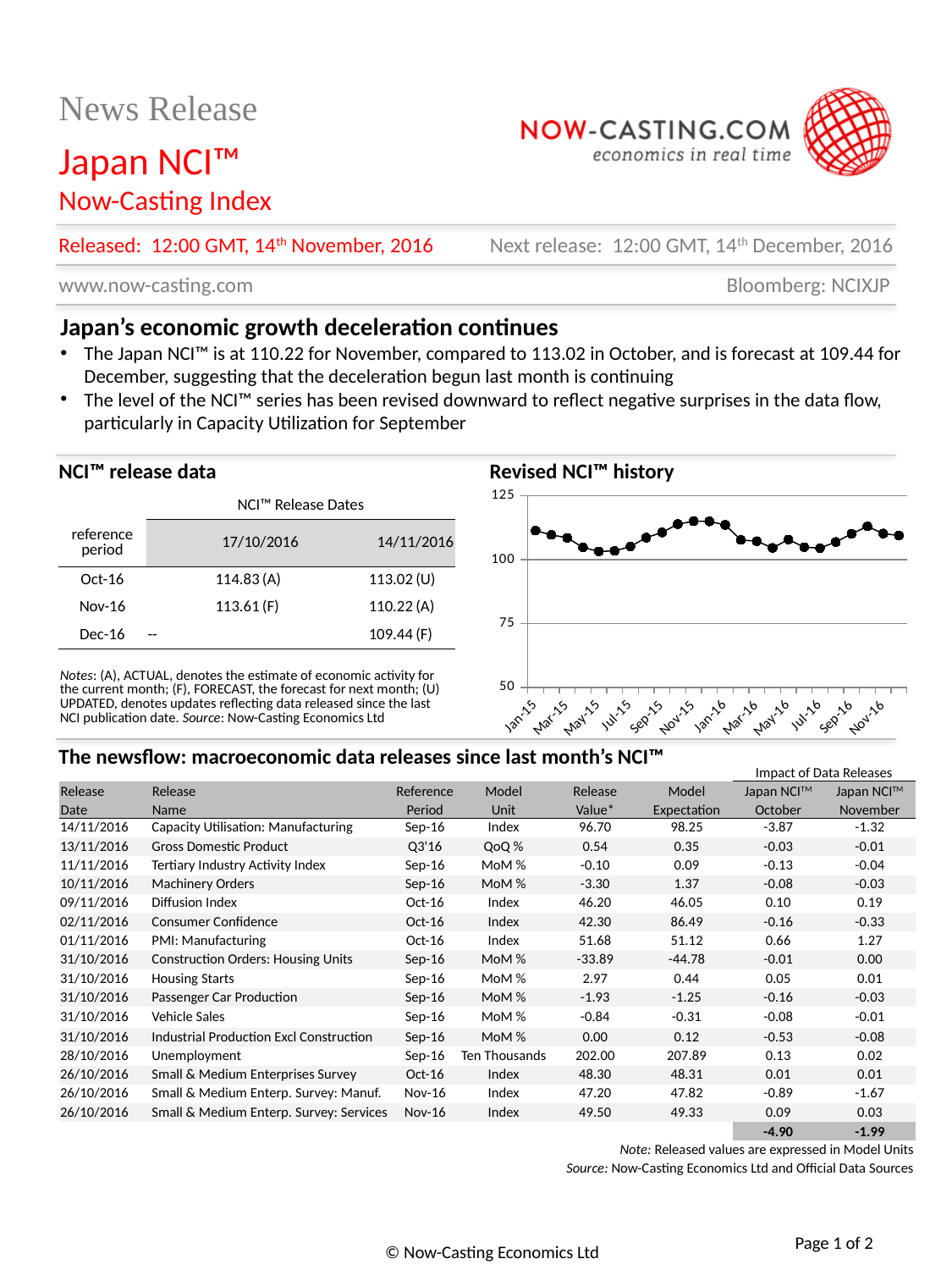
In the "Revised NCI™ history" chart, do the values rise or fall from May-15 to Nov-15? rise In the "Revised NCI™ history" chart, do the values rise or fall from Jan-15 to May-15? fall In the "Revised NCI™ history" chart, is the value for Jan-15 greater or less than 100? greater What is the title of the chart on the slide? Revised NCI™ history In the "Revised NCI™ history" chart, is the value for Nov-16 greater or less than 75? greater In the "Revised NCI™ history" chart, which is higher, the value for Nov-15 or the value for May-15? Nov-15 In the "Revised NCI™ history" chart, which is higher, the value for Jan-15 or the value for Jul-15? Jan-15 In the "Revised NCI™ history" chart, do the values rise or fall from Nov-15 to Mar-16? fall In the "Revised NCI™ history" chart, is the value for Nov-15 greater or less than 125? less In the "Revised NCI™ history" chart, what is the highest value shown on the y axis? 125 What kind of chart is the "Revised NCI™ history" chart? line chart How many month labels are shown on the x axis of the "Revised NCI™ history" chart? 12